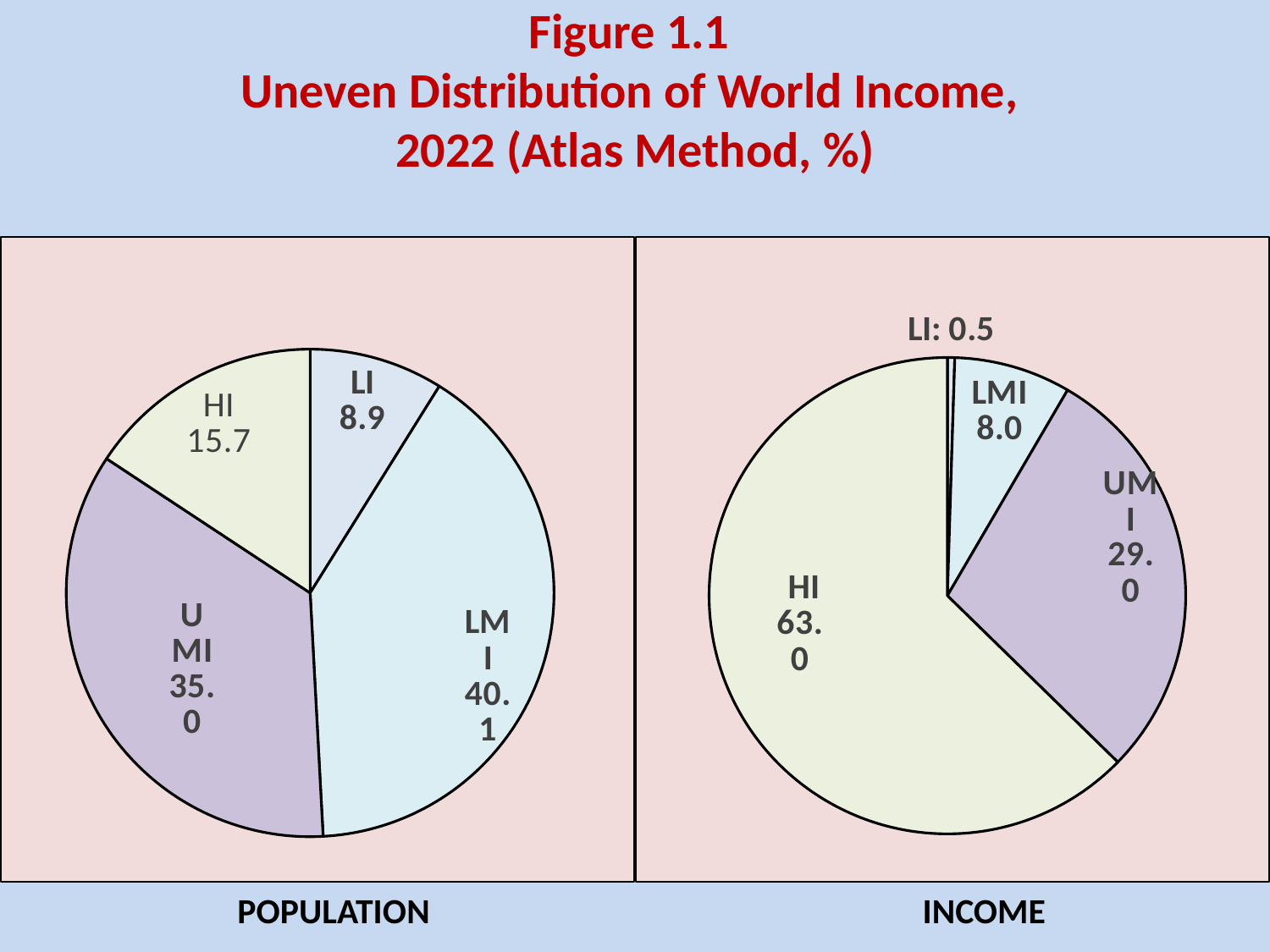
In the INCOME pie chart, what is the value for HI? 63.0 What is the title of the figure on the slide? Figure 1.1 Uneven Distribution of World Income, 2022 (Atlas Method, %) What type of chart is used for the POPULATION data? Pie chart How many slices does the INCOME pie chart have? 4 Which is larger: the HI value in the POPULATION chart or the HI value in the INCOME chart? INCOME In the POPULATION pie chart, which category has the smallest share? LI In the POPULATION pie chart, which category has the largest share? LMI In the INCOME pie chart, which category has the smallest share? LI In the POPULATION pie chart, what is the difference between the LMI and UMI values? 5.1 In the INCOME pie chart, what is the difference between the HI and UMI values? 34.0 In the POPULATION pie chart, what is the value for LMI? 40.1 In the INCOME pie chart, what is the value for LI? 0.5